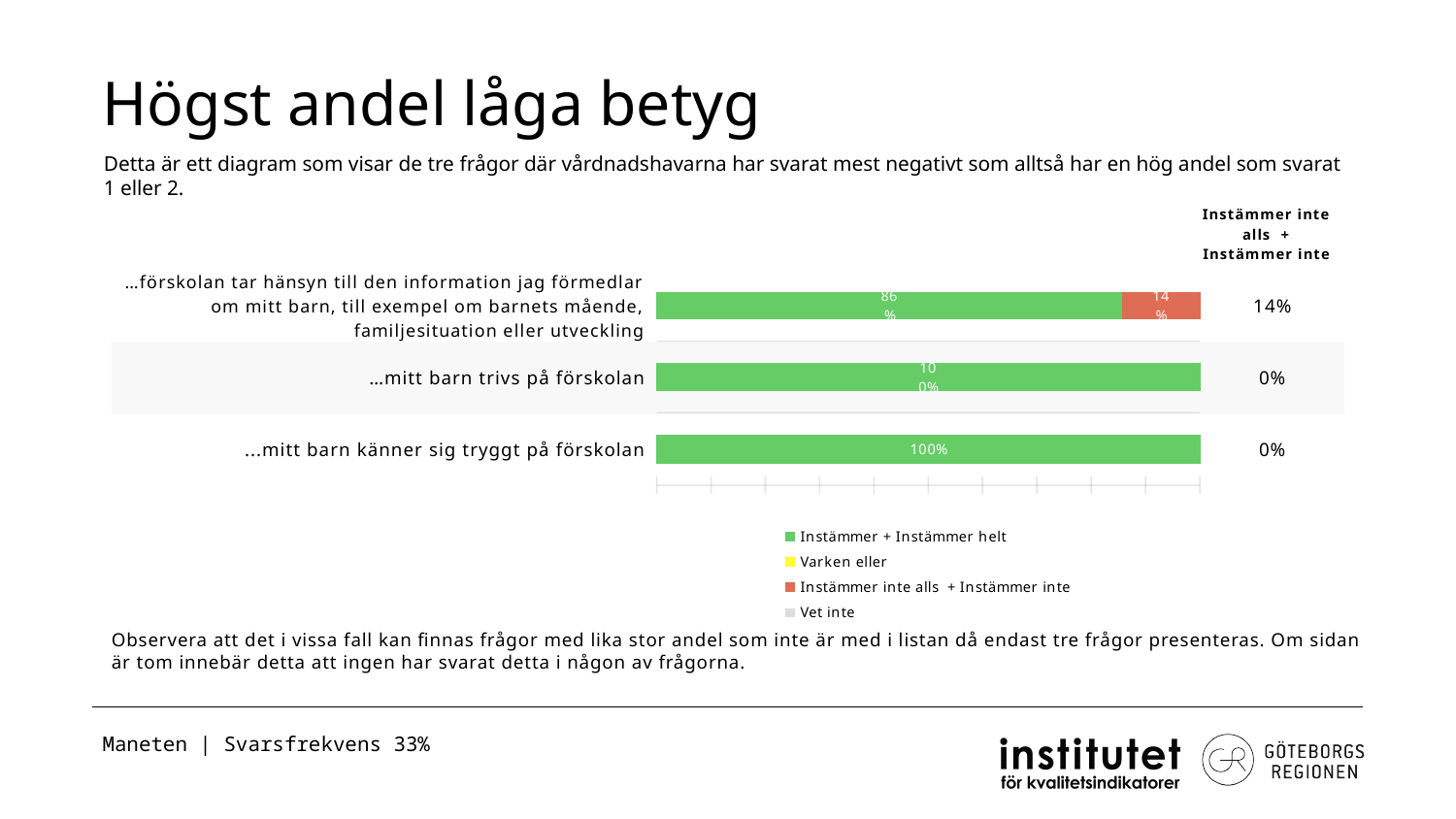
What colour represents "Instämmer inte alls + Instämmer inte" in the legend? red What kind of chart is shown on the slide? bar chart What is the value of "Instämmer inte alls + Instämmer inte" for "…förskolan tar hänsyn till den information jag förmedlar om mitt barn, till exempel om barnets mående, familjesituation eller utveckling"? 14% How many categories (questions) are plotted in the chart? 3 What is the value of "Instämmer + Instämmer helt" for "…mitt barn känner sig tryggt på förskolan"? 100% Which is larger: the "Instämmer + Instämmer helt" share for "…mitt barn trivs på förskolan" or for "…förskolan tar hänsyn till den information jag förmedlar om mitt barn…"? …mitt barn trivs på förskolan What is the value of "Instämmer + Instämmer helt" for "…förskolan tar hänsyn till den information jag förmedlar om mitt barn, till exempel om barnets mående, familjesituation eller utveckling"? 86% What is the difference between the "Instämmer + Instämmer helt" share for "…mitt barn känner sig tryggt på förskolan" and for "…förskolan tar hänsyn till den information jag förmedlar om mitt barn…"? 14% Which category has the highest share of "Instämmer inte alls + Instämmer inte"? …förskolan tar hänsyn till den information jag förmedlar om mitt barn, till exempel om barnets mående, familjesituation eller utveckling What is the "Instämmer inte alls + Instämmer inte" value shown to the right of the bar for "…mitt barn trivs på förskolan"? 0% How many series does the legend list? 4 What is the value of "Instämmer + Instämmer helt" for "…mitt barn trivs på förskolan"? 100%